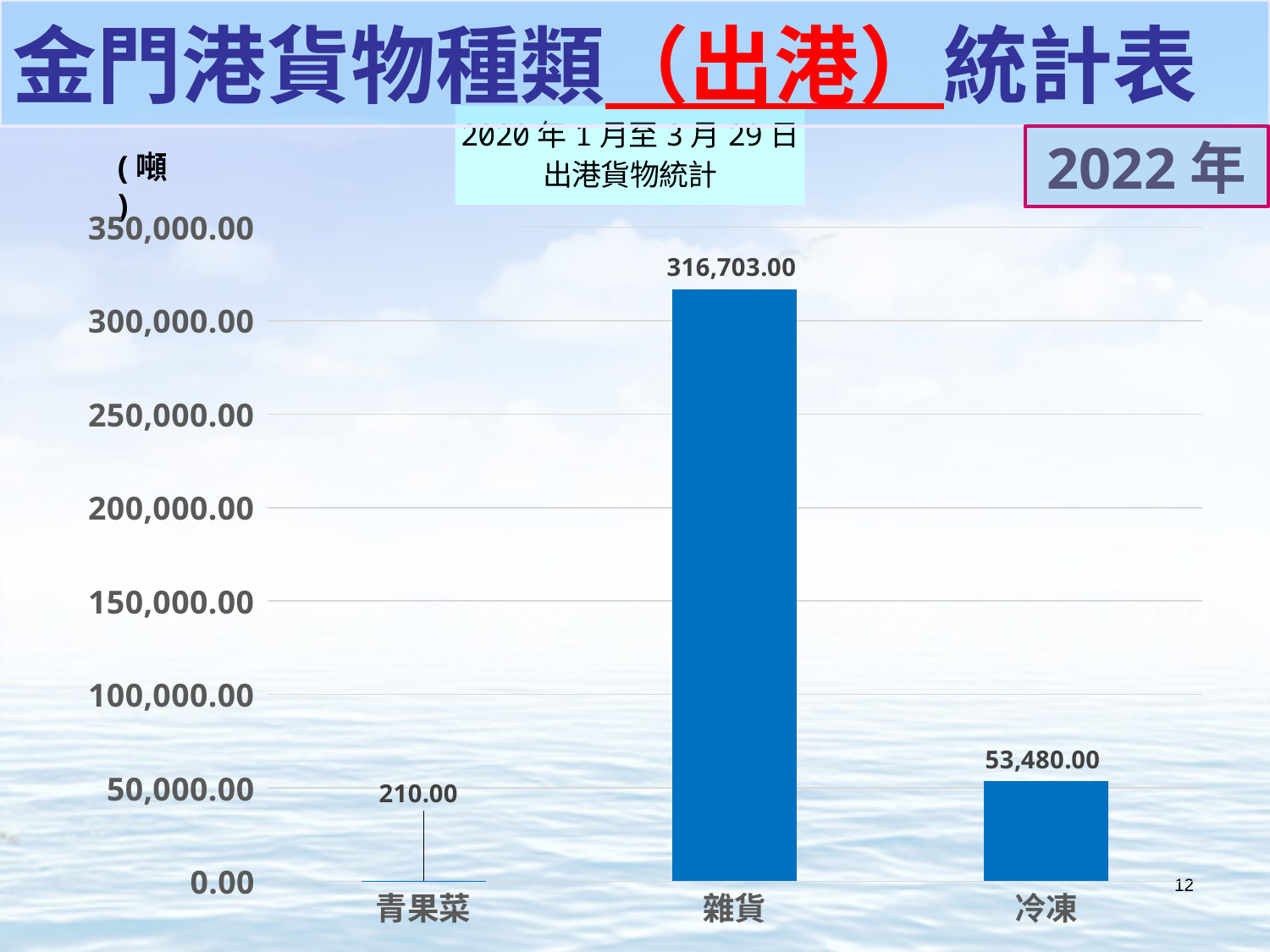
What is the value for 青果菜? 210.00 What is the difference between the values for 冷凍 and 青果菜? 53,270.00 What is the difference between the values for 雜貨 and 冷凍? 263,223.00 Which category has the lowest value? 青果菜 What is the value for 雜貨? 316,703.00 What unit is shown on the y axis of the chart? 噸 What kind of chart is shown on the slide? bar chart Is the value for 雜貨 greater or less than 300,000.00? greater How many categories are shown on the x axis? 3 What is the value for 冷凍? 53,480.00 Which category has the highest value? 雜貨 Which is larger, the value for 冷凍 or the value for 青果菜? 冷凍